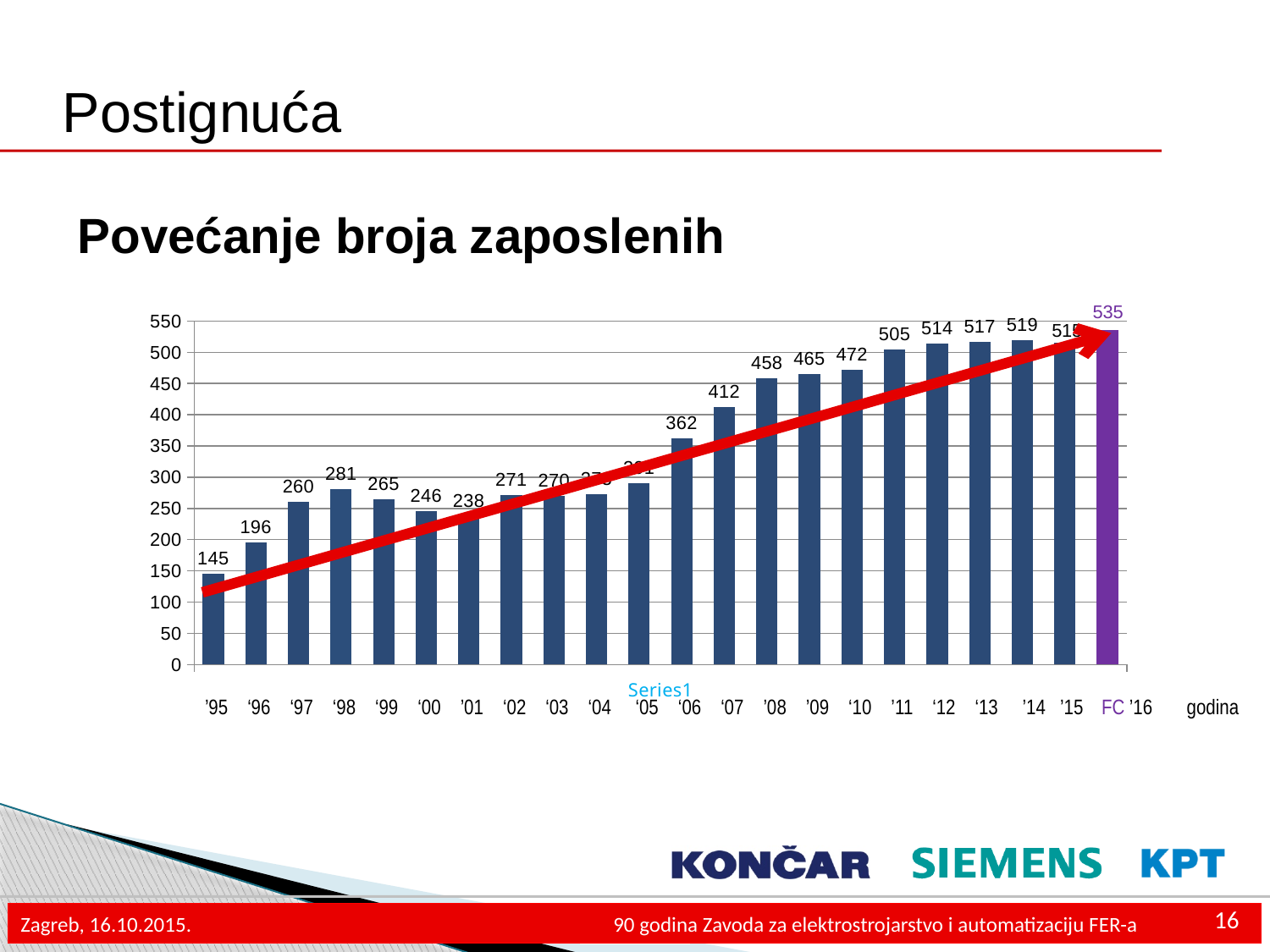
What value is shown for FC '16? 535 What is the difference between the values for '96 and '95? 51 What value is shown for '07? 412 What kind of chart is shown on the slide? bar chart Which year has the larger value, '98 or '99? '98 What is the number of employees shown for '95? 145 Which year has the highest value in the chart? FC '16 Is the value for '04 greater or less than 250? greater What value is shown for '98? 281 Do the values generally rise or fall from '95 to FC '16? rise Which year has the lowest value in the chart? '95 What is the difference between the values for '07 and '06? 50